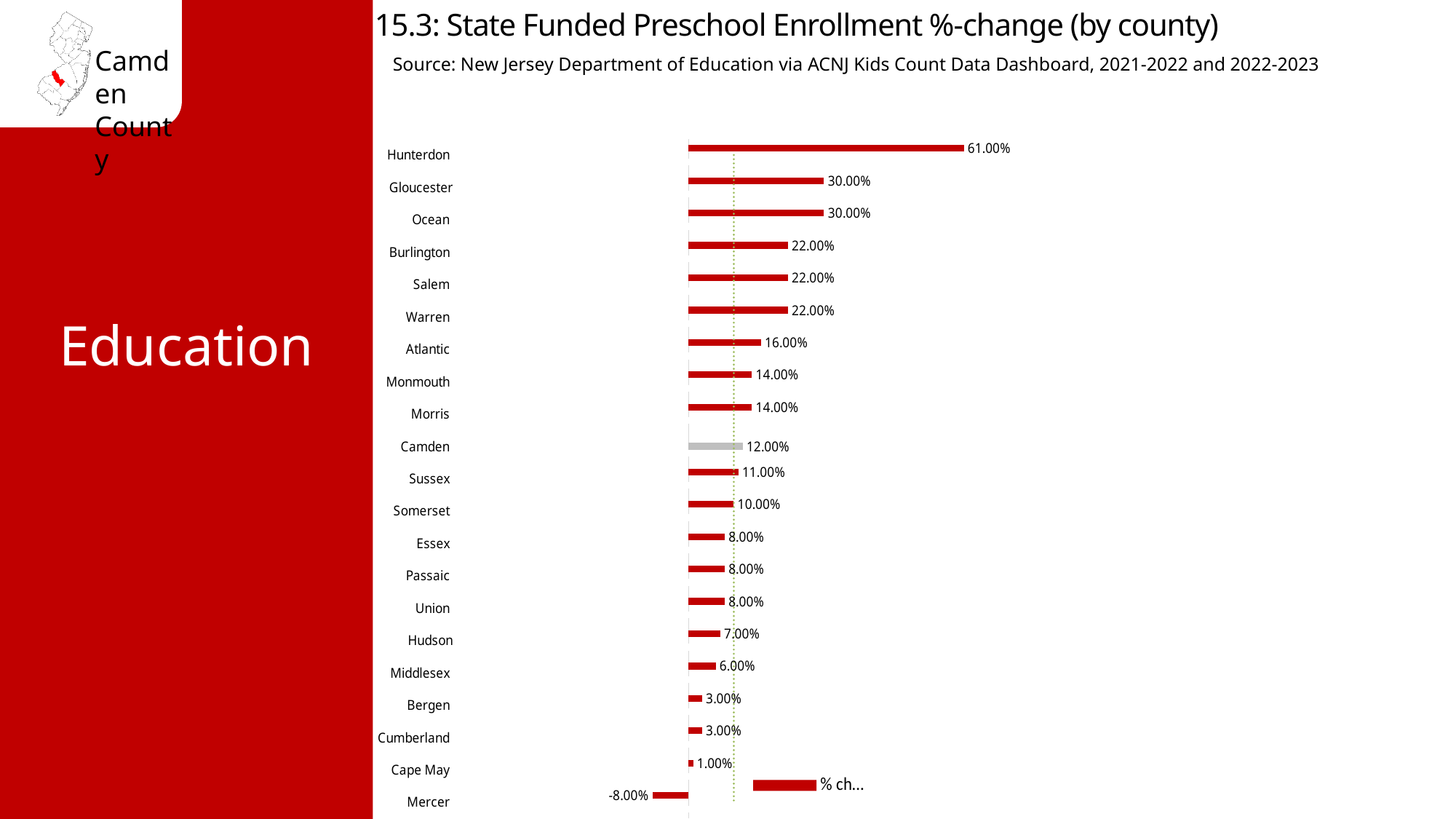
Which is larger, the value for Burlington or the value for Monmouth? Burlington Which county has the highest value? Hunterdon What kind of chart is shown on the slide? Bar chart What is the value for Mercer? -8.00% What is the difference between the values for Camden and Cape May? 11.00% What is the value for Atlantic? 16.00% What is the value for Hunterdon? 61.00% What is the value for Camden? 12.00% Which county has the lowest value? Mercer What is the difference between the values for Hunterdon and Gloucester? 31.00% Which county's bar is coloured grey instead of red? Camden How many counties are shown in the chart? 21